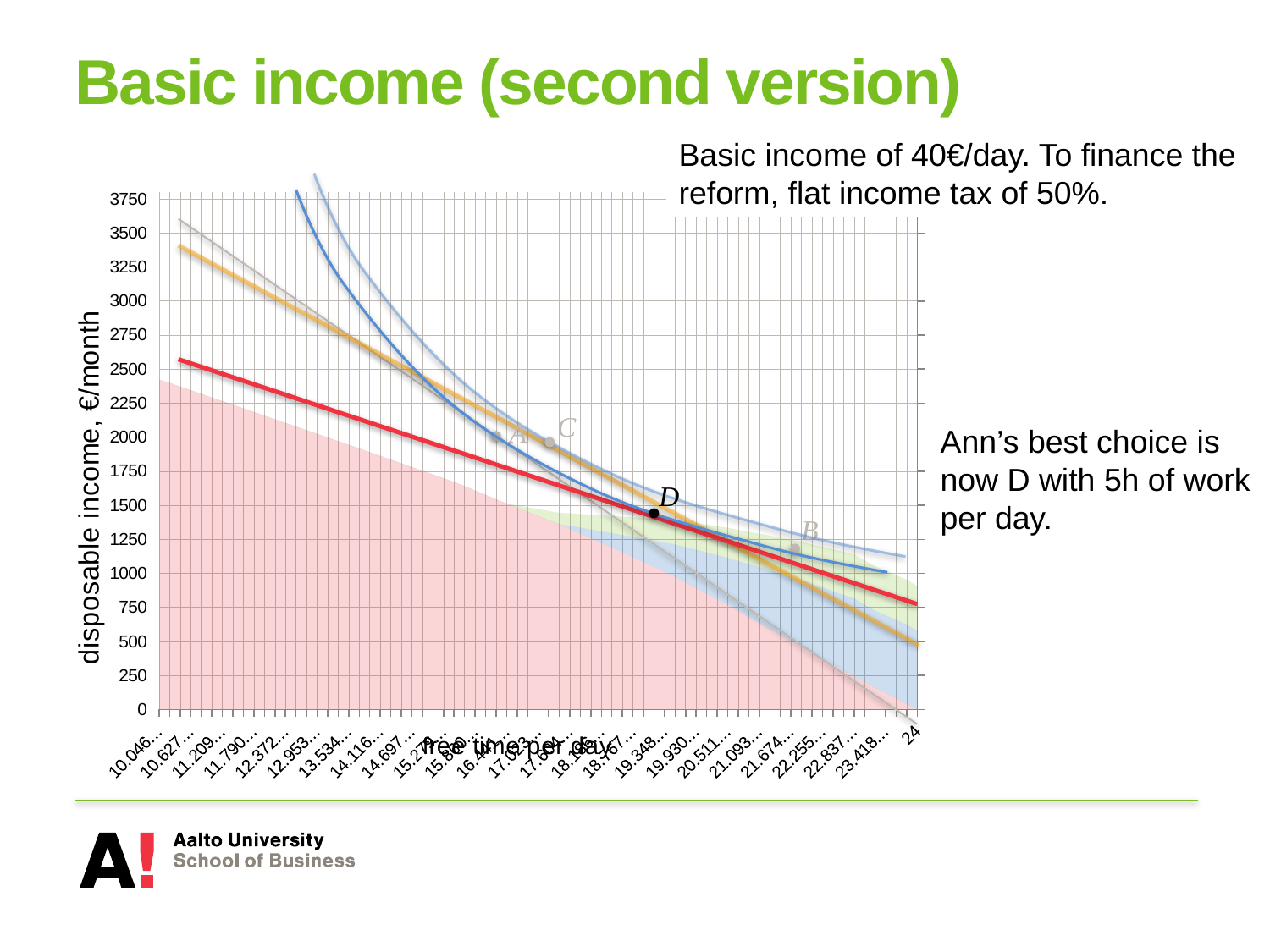
Is the disposable income at point C greater or less than 1750? greater Is the disposable income at point D greater or less than 1500? less Which point has the higher disposable income, D or B? D Is the disposable income at point D greater or less than 1250? greater Which point has the higher disposable income, C or D? C What is the title of the horizontal axis of the chart? free time per day What is the last label shown on the horizontal axis? 24 Does the red line rise or fall as free time per day increases along the x axis? fall What kind of chart is shown on the slide? area chart What is the title of the vertical axis of the chart? disposable income, €/month What is the highest tick value shown on the vertical axis? 3750